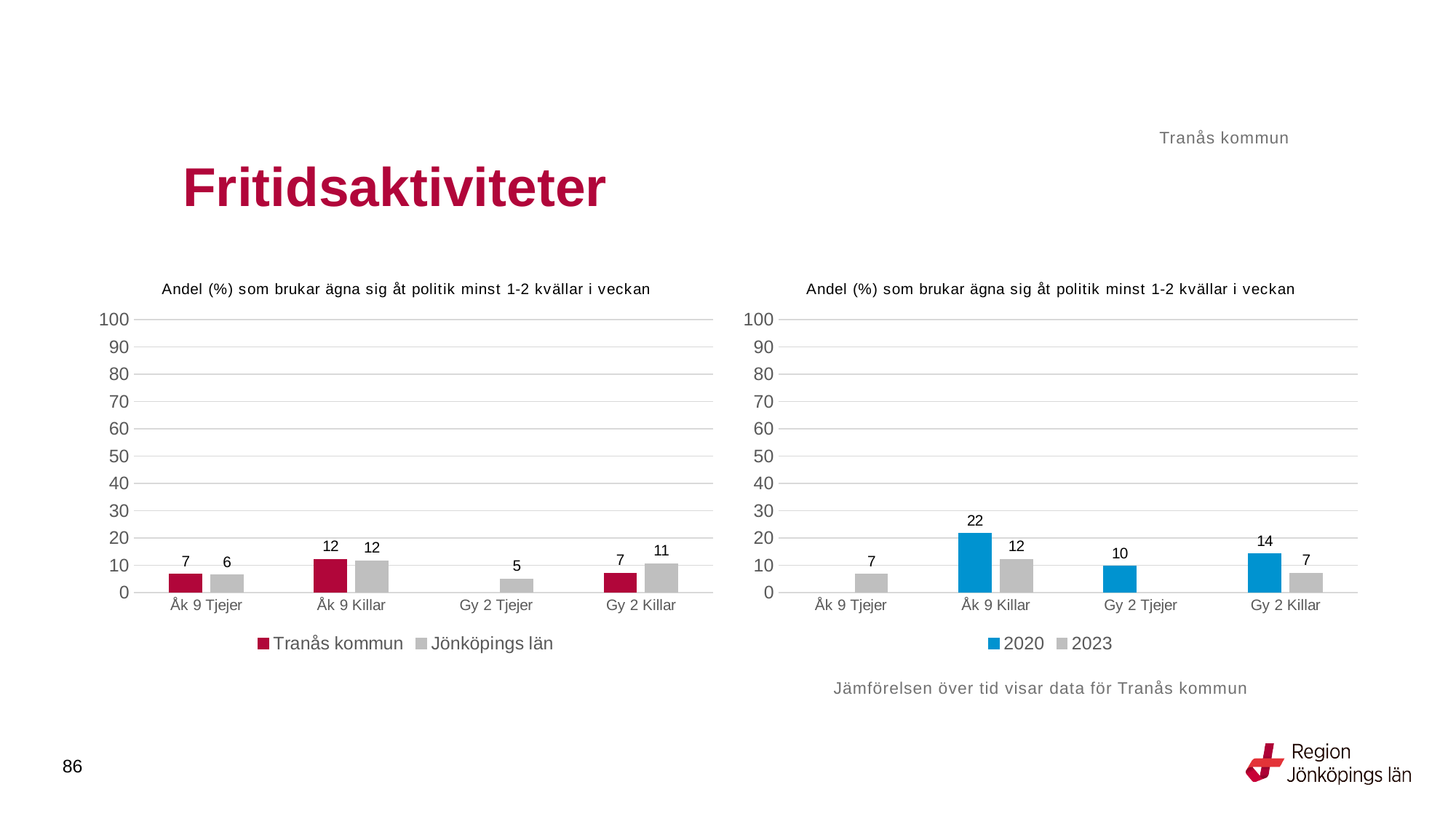
In the right chart, what is the value for 2023 for Gy 2 Killar? 7 In the left chart, what is the value for Tranås kommun for Åk 9 Killar? 12 In the right chart, is the value for 2020 for Åk 9 Killar greater or less than 20? greater In the left chart, what is the difference between Jönköpings län and Tranås kommun for Gy 2 Killar? 4 In the right chart, what is the value for 2020 for Åk 9 Killar? 22 How many categories are shown on the x axis of the right chart? 4 In the left chart, which category has the highest value for Jönköpings län? Åk 9 Killar In the right chart, which is larger for Åk 9 Killar, 2020 or 2023? 2020 What type of chart is the left chart? Bar chart In the left chart, how many series does the legend list? 2 In the right chart, what is the difference between 2020 and 2023 for Åk 9 Killar? 10 In the left chart, what is the value for Jönköpings län for Gy 2 Tjejer? 5